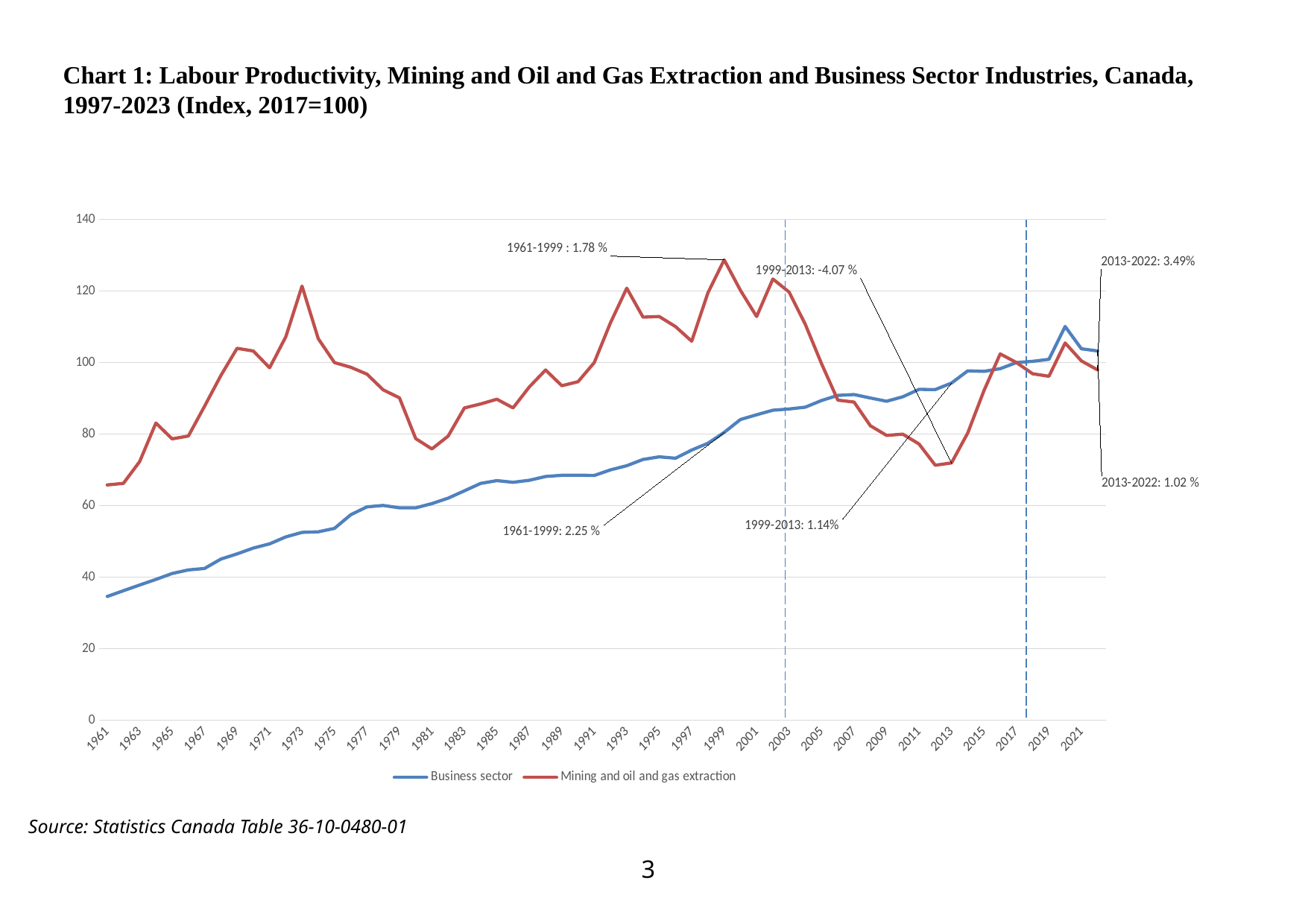
In 2013, which series has the higher value, Business sector or Mining and oil and gas extraction? Business sector What two growth rates are annotated for the period 2013-2022? 3.49% and 1.02 % What are the two series named in the legend? Business sector; Mining and oil and gas extraction How many series does the legend list? 2 What growth rate is annotated for the period 1999-2013 with the leader line pointing to the Mining and oil and gas extraction line? -4.07 % Is the value for the Business sector in 1961 greater or less than 40? less Does the Business sector line generally rise or fall from 1961 to 2021? rise What growth rate is annotated for the period 1999-2013 with the leader line pointing to the Business sector line? 1.14% Is the value for Mining and oil and gas extraction in 1999 greater or less than 120? greater What type of chart is shown on the slide? line chart What colour is the line for Mining and oil and gas extraction? red Is the value for the Business sector in 1991 greater or less than 80? less